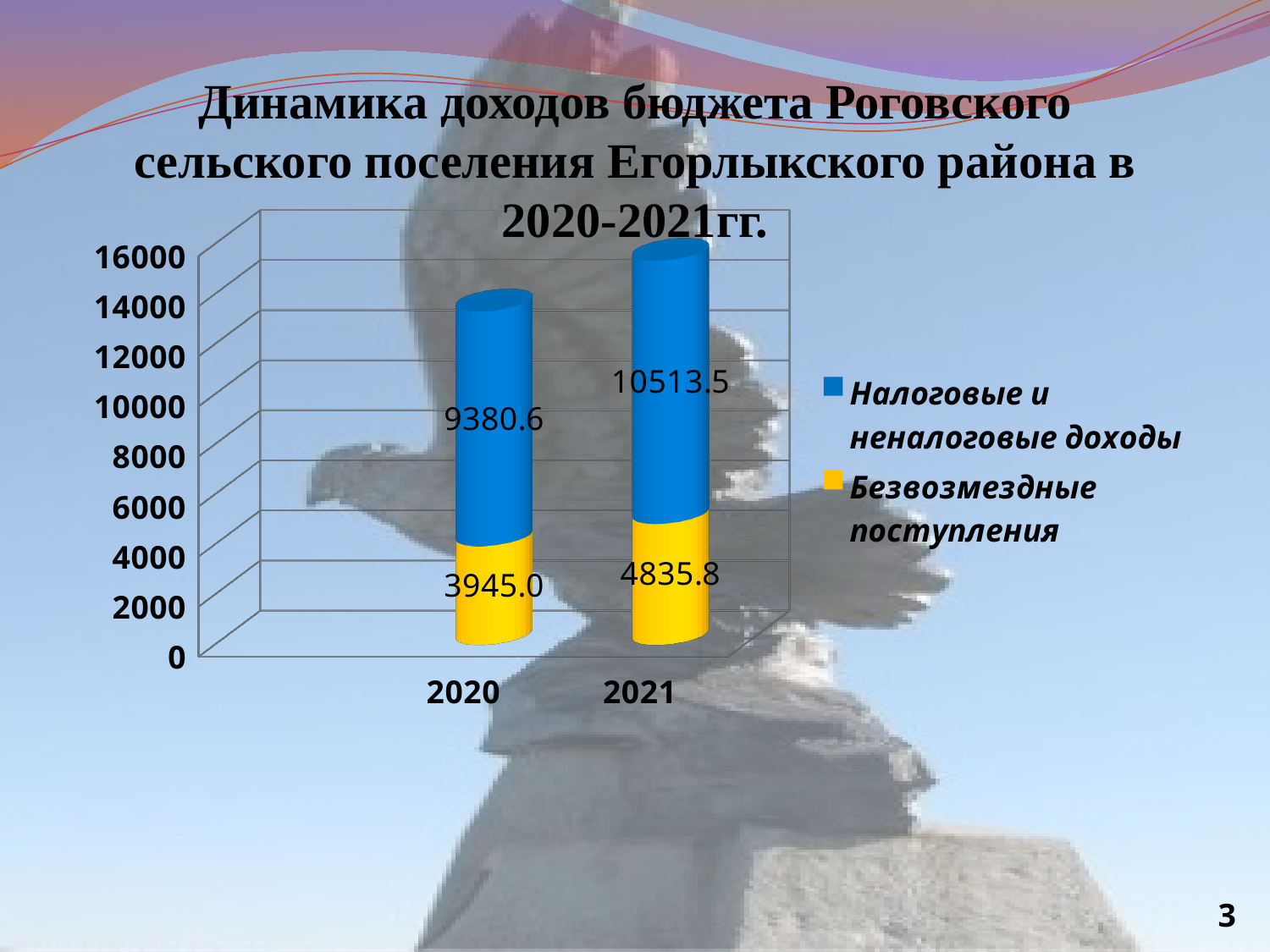
What kind of chart is shown on the slide? Stacked bar chart What is the total of the stacked bar for 2020? 13325.6 What is the value of Безвозмездные поступления for 2020? 3945.0 Do the values for Безвозмездные поступления rise or fall from 2020 to 2021? Rise What is the total of the stacked bar for 2021? 15349.3 How many series does the legend list? 2 What is the value of Налоговые и неналоговые доходы for 2021? 10513.5 What is the value of Безвозмездные поступления for 2021? 4835.8 By how much did Налоговые и неналоговые доходы increase from 2020 to 2021? 1132.9 Which year has the lower value for Безвозмездные поступления? 2020 What is the value of Налоговые и неналоговые доходы for 2020? 9380.6 Which year has the higher value for Налоговые и неналоговые доходы? 2021